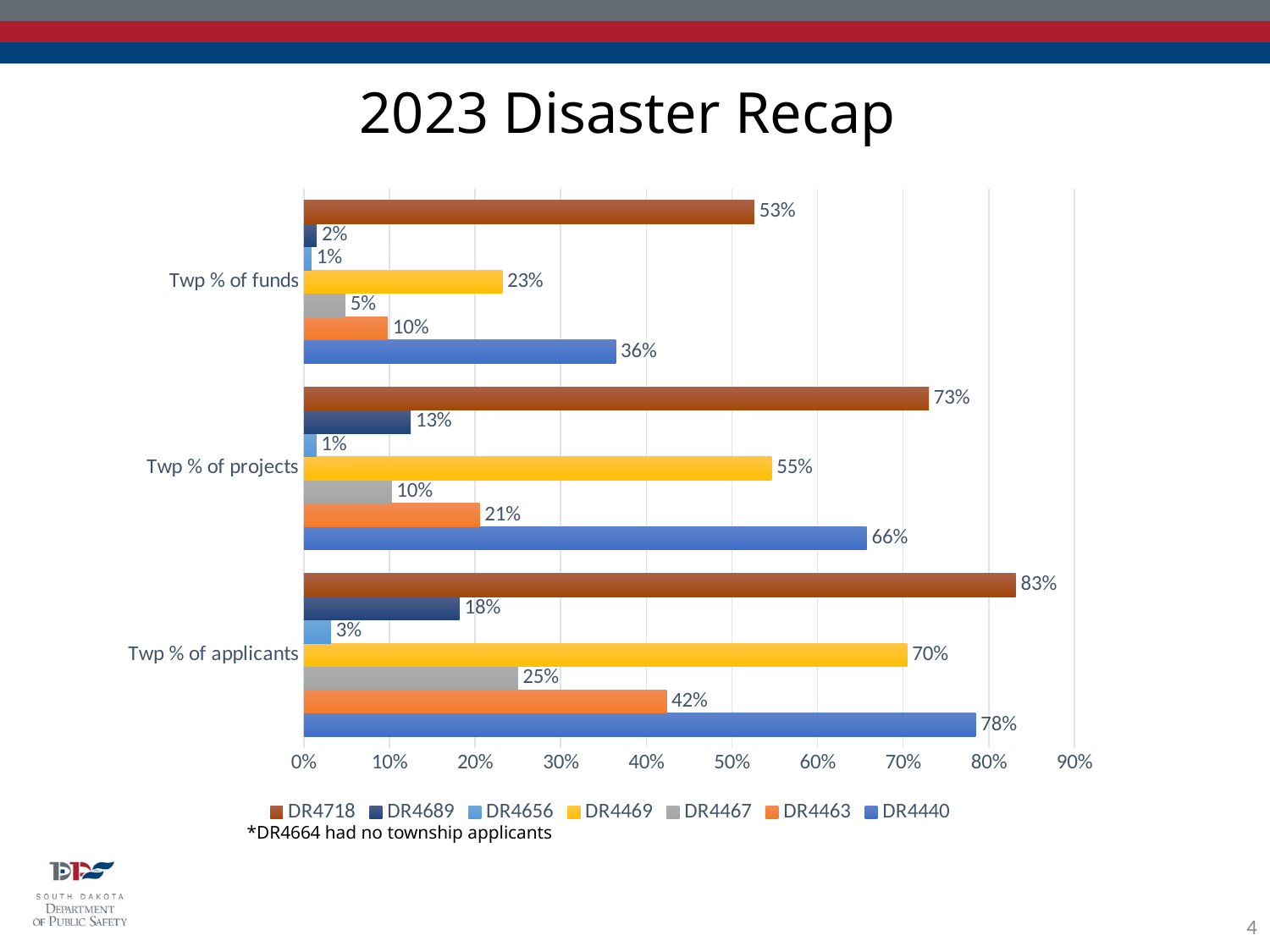
Which series has the highest value in the Twp % of projects category? DR4718 How many series does the legend list? 7 What is the value for DR4440 in the Twp % of funds category? 36% What is the value for DR4718 in the Twp % of applicants category? 83% What is the value for DR4469 in the Twp % of projects category? 55% Which is larger in the Twp % of applicants category, DR4469 or DR4463? DR4469 What is the difference between DR4718 and DR4440 in the Twp % of funds category? 17% What is the title of the chart? 2023 Disaster Recap What kind of chart is shown on the slide? Bar chart Which series has the lowest value in the Twp % of applicants category? DR4656 How many categories are shown on the vertical axis? 3 What does the footnote below the legend say? *DR4664 had no township applicants